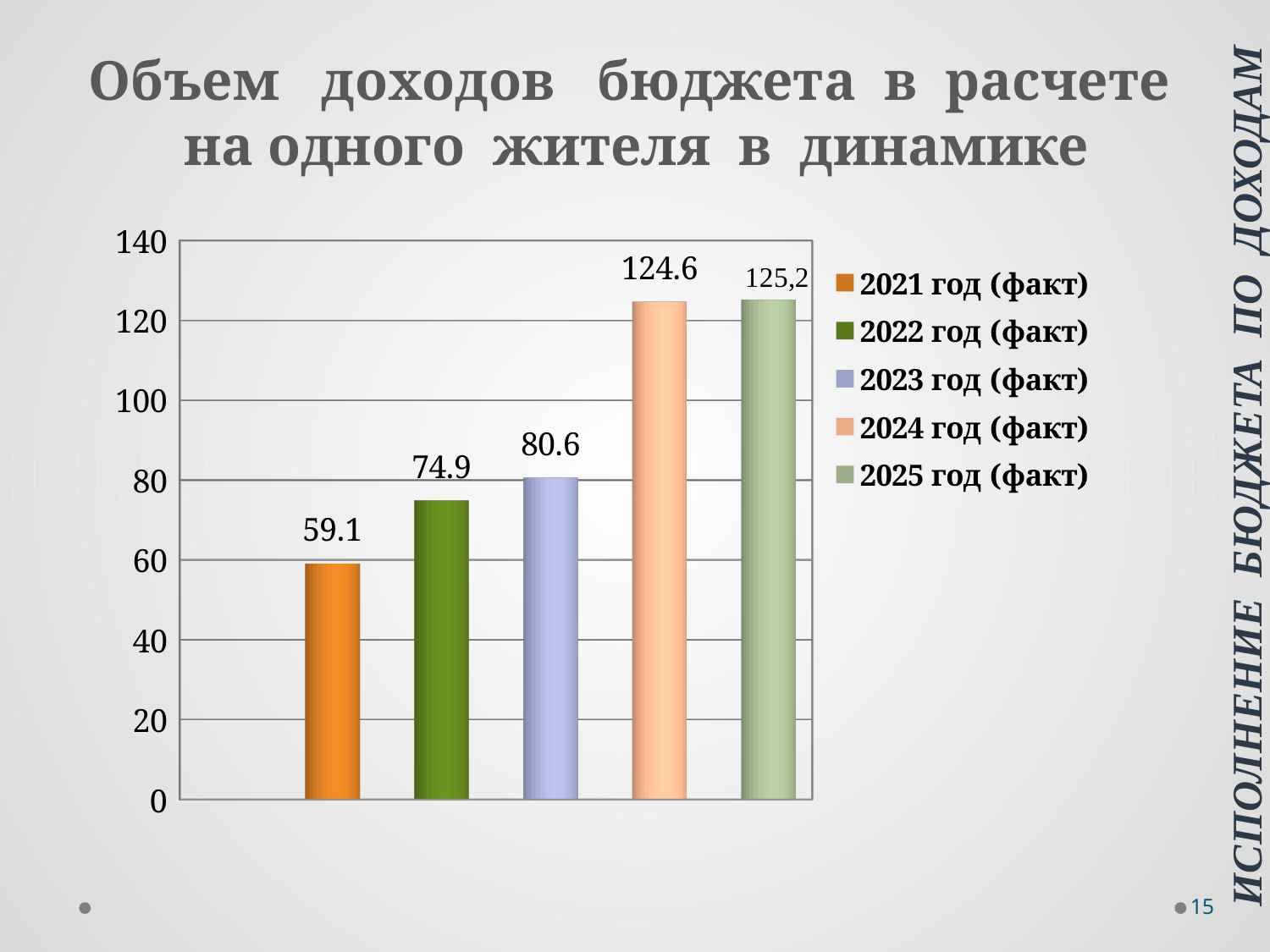
What is the value for 2025 год (факт)? 125,2 What is the difference between the values for 2024 год (факт) and 2021 год (факт)? 65.5 What is the difference between the values for 2022 год (факт) and 2021 год (факт)? 15.8 What is the value for 2021 год (факт)? 59.1 What is the value for 2023 год (факт)? 80.6 Which year has the highest value? 2025 год (факт) How many entries does the legend list? 5 Is the value for 2024 год (факт) greater or less than 120? greater What kind of chart is shown on the slide? bar chart How many bars are shown in the chart? 5 Which is larger, the value for 2023 год (факт) or 2022 год (факт)? 2023 год (факт) Which year has the lowest value? 2021 год (факт)